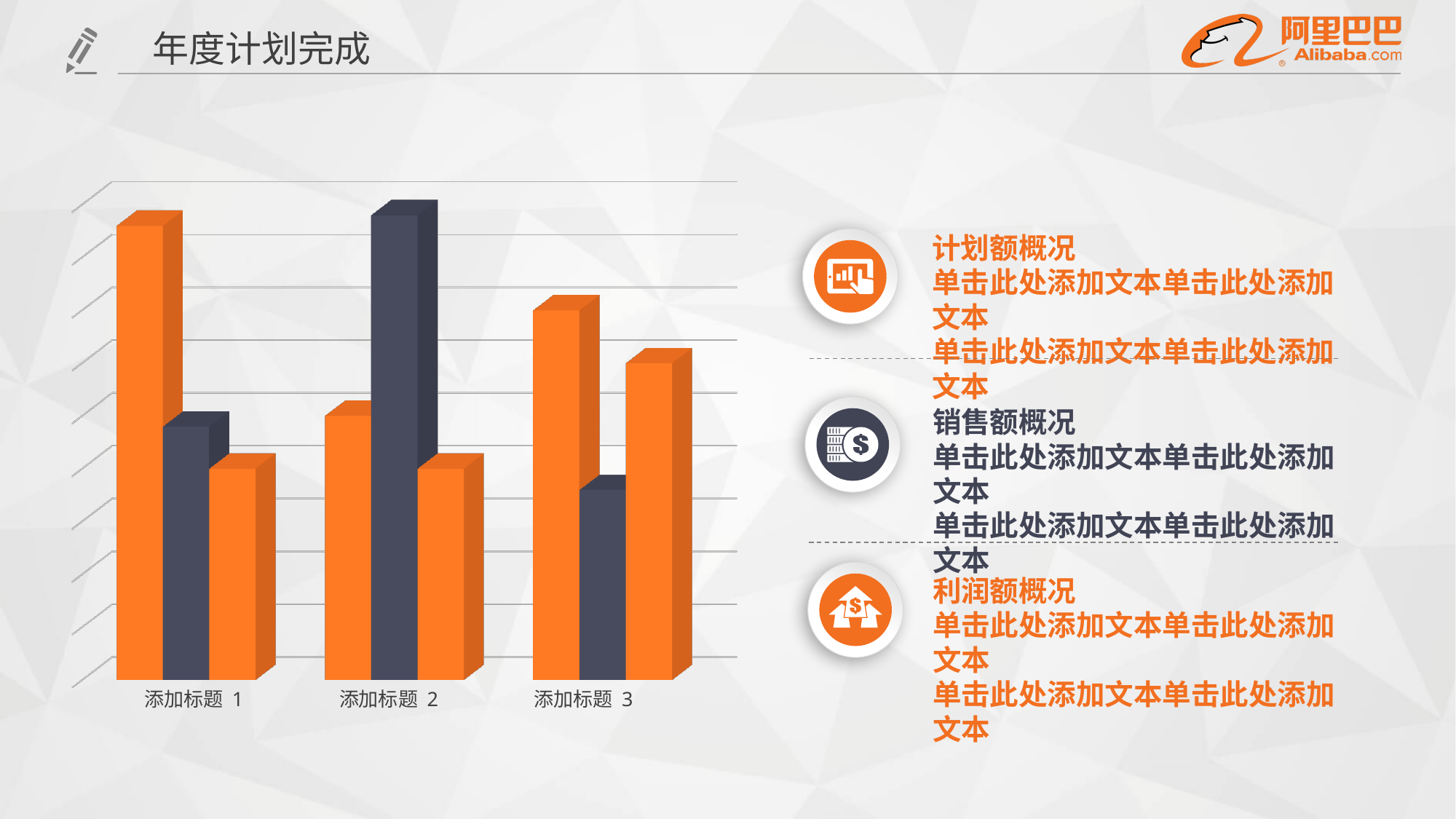
Which category has the shortest leftmost orange bar? 添加标题 2 How many categories are shown on the x axis of the chart? 3 What kind of chart is shown on the slide? Bar chart In category 添加标题 2, which is taller: the dark gray bar or the leftmost orange bar? The dark gray bar What is the title shown at the top of the slide above the chart? 年度计划完成 Which category has the tallest dark gray bar? 添加标题 2 What is the label of the first category on the x axis? 添加标题 1 How many bars are drawn for each category in the chart? 3 In category 添加标题 1, which is taller: the leftmost orange bar or the dark gray bar? The leftmost orange bar Which category has the tallest leftmost orange bar? 添加标题 1 Which category has the shortest dark gray bar? 添加标题 3 In category 添加标题 3, which is taller: the dark gray bar or the rightmost orange bar? The rightmost orange bar